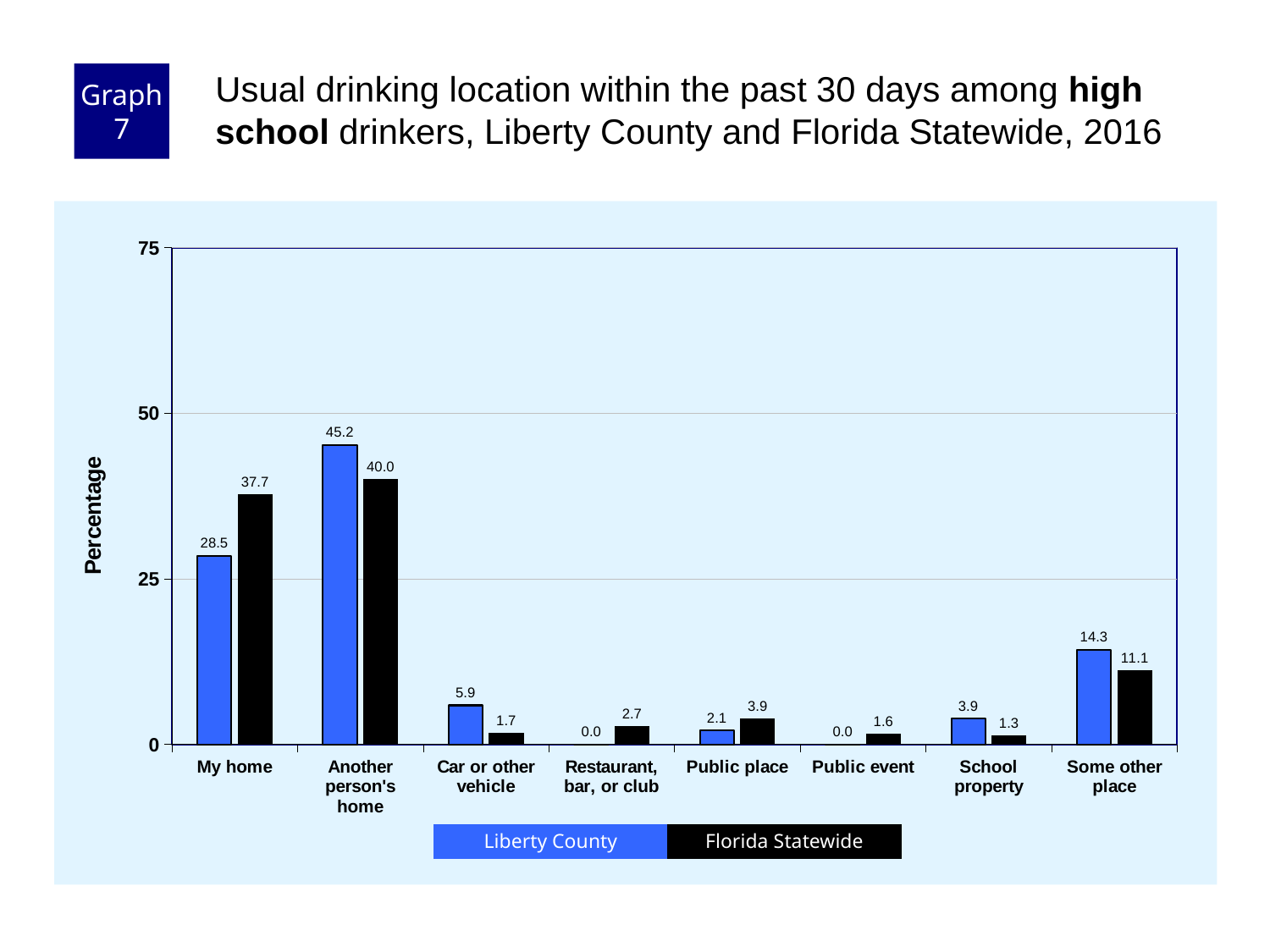
What is the difference between the Liberty County and Florida Statewide values for "Another person's home"? 5.2 What is the Florida Statewide value for "My home"? 37.7 Which is larger for "My home": Liberty County or Florida Statewide? Florida Statewide How many categories are shown on the x axis? 8 Which category has the highest Liberty County value? Another person's home Is the Liberty County value for "My home" greater or less than 25? greater What kind of chart is shown on the slide? Bar chart What is the Liberty County value for "Some other place"? 14.3 What is the Liberty County value for "Another person's home"? 45.2 Which category has the lowest Florida Statewide value? School property How many series does the legend list? 2 Which colour represents Florida Statewide in the chart? Black